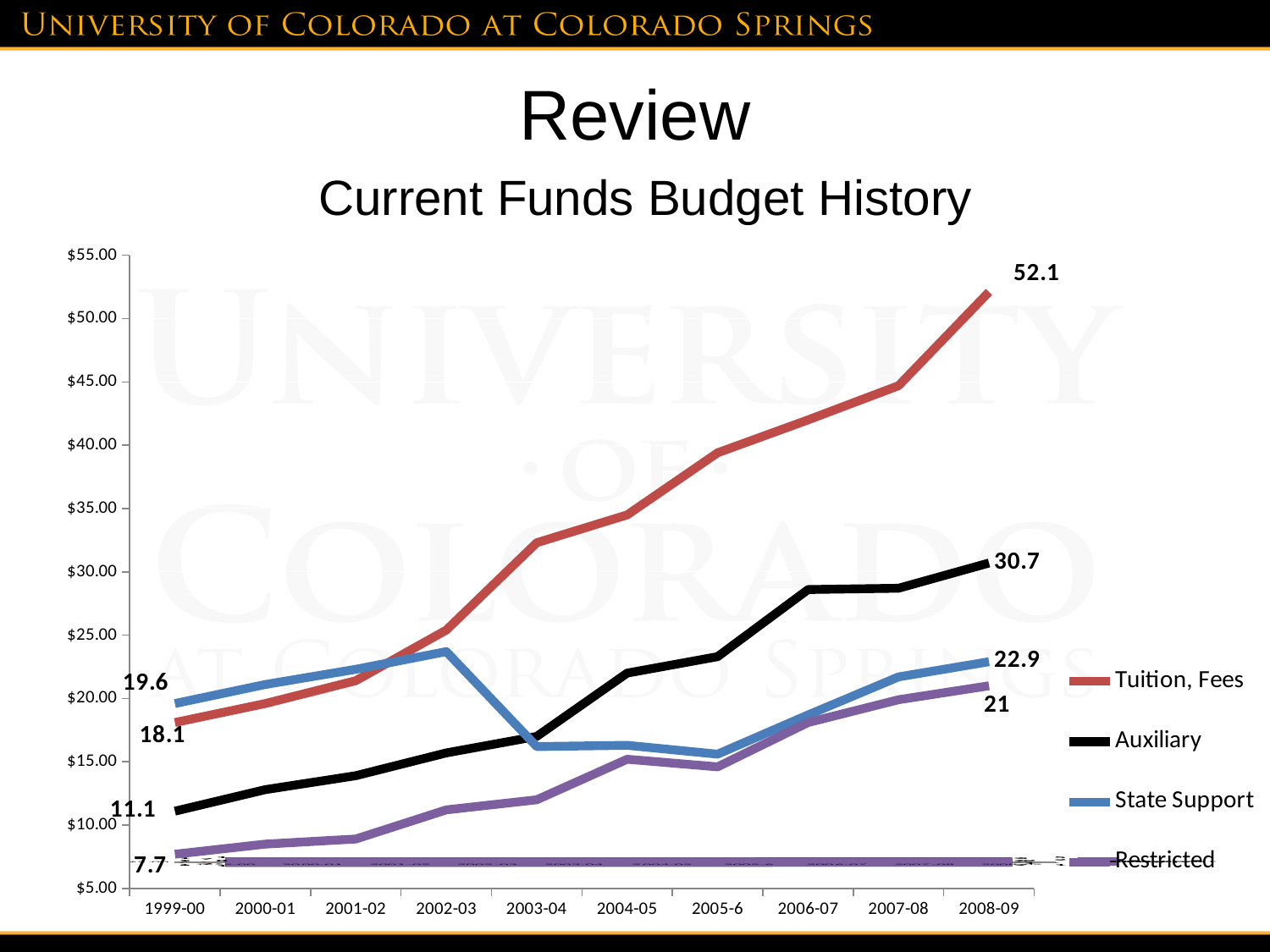
What is the value for State Support in 2008-09? 22.9 Which series has the highest value in 2008-09? Tuition, Fees What kind of chart is shown on the slide? line chart By how much did Tuition, Fees increase from 1999-00 to 2008-09? 34 What is the value for Auxiliary in 1999-00? 11.1 Which series has the lowest value in 1999-00? Restricted In 1999-00, which was larger: State Support or Tuition, Fees? State Support How many series does the legend list? 4 What is the value for Restricted in 1999-00? 7.7 By how much did Auxiliary increase from 1999-00 to 2008-09? 19.6 What is the value for Tuition, Fees in 2008-09? 52.1 Is the value for Tuition, Fees in 2005-6 greater or less than $35.00? greater